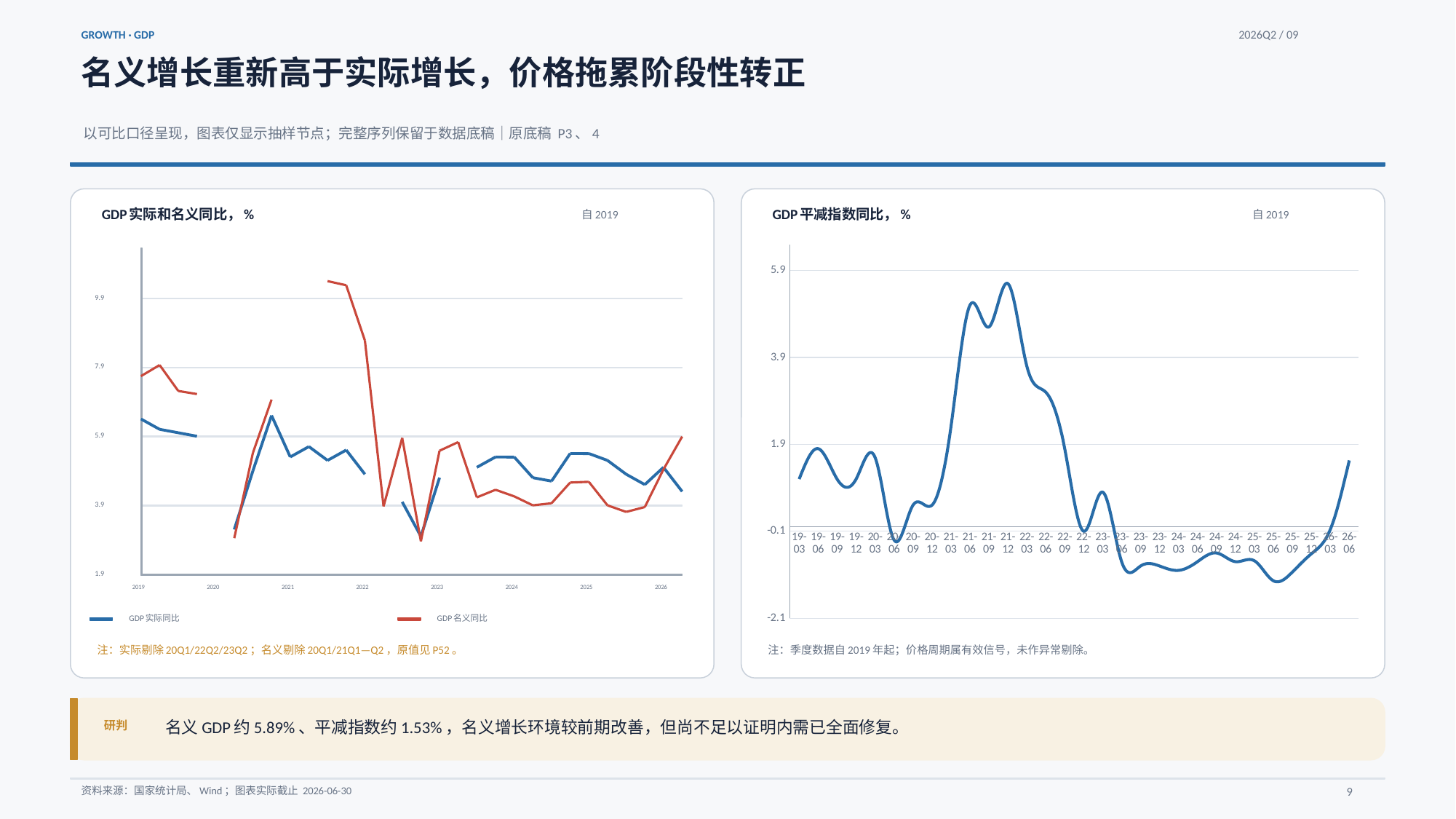
In the right chart 'GDP 平减指数同比，%', is the value for 23-06 greater or less than -0.1? less How many year labels are shown on the x axis of the left chart 'GDP 实际和名义同比，%'? 8 In the right chart 'GDP 平减指数同比，%', is the value for 21-12 greater or less than 3.9? greater In the left chart 'GDP 实际和名义同比，%', is the highest point of the GDP 名义同比 line greater or less than 9.9? greater What kind of chart is the right chart titled 'GDP 平减指数同比，%'? line chart What kind of chart is the left chart titled 'GDP 实际和名义同比，%'? line chart In the left chart 'GDP 实际和名义同比，%', which series is higher at the last plotted point in 2026? GDP 名义同比 How many series does the legend of the left chart 'GDP 实际和名义同比，%' list? 2 In the right chart 'GDP 平减指数同比，%', at which quarter does the line reach its highest point? 21-12 In the right chart 'GDP 平减指数同比，%', does the line rise or fall between 21-12 and 23-06? fall In the left chart 'GDP 实际和名义同比，%', which series is higher at the first plotted point in 2019? GDP 名义同比 What are the two legend entries of the left chart 'GDP 实际和名义同比，%'? GDP 实际同比, GDP 名义同比